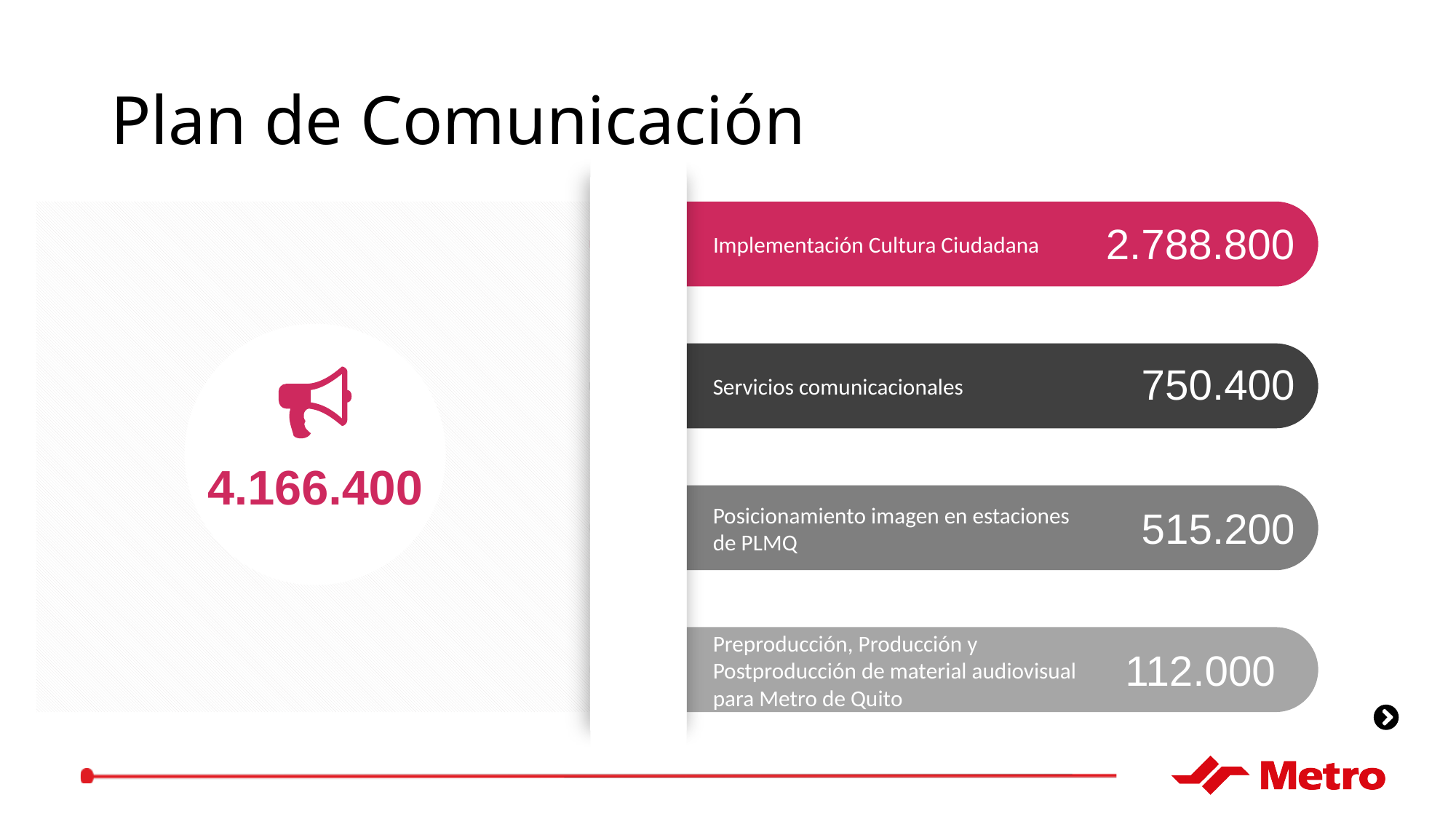
What is the value shown for Preproducción, Producción y Postproducción de material audiovisual para Metro de Quito? 112.000 What is the value shown for Servicios comunicacionales? 750.400 Which is larger, the value for Servicios comunicacionales or the value for Posicionamiento imagen en estaciones de PLMQ? Servicios comunicacionales Which item has the lowest value? Preproducción, Producción y Postproducción de material audiovisual para Metro de Quito What is the difference between the values for Implementación Cultura Ciudadana and Servicios comunicacionales? 2.038.400 What is the total of the four listed values, as shown in the circle on the left? 4.166.400 What is the difference between the values for Servicios comunicacionales and Posicionamiento imagen en estaciones de PLMQ? 235.200 How many items are listed with values on the slide? 4 Which item has the highest value? Implementación Cultura Ciudadana What is the value shown for Implementación Cultura Ciudadana? 2.788.800 What is the title of the slide? Plan de Comunicación What is the value shown for Posicionamiento imagen en estaciones de PLMQ? 515.200